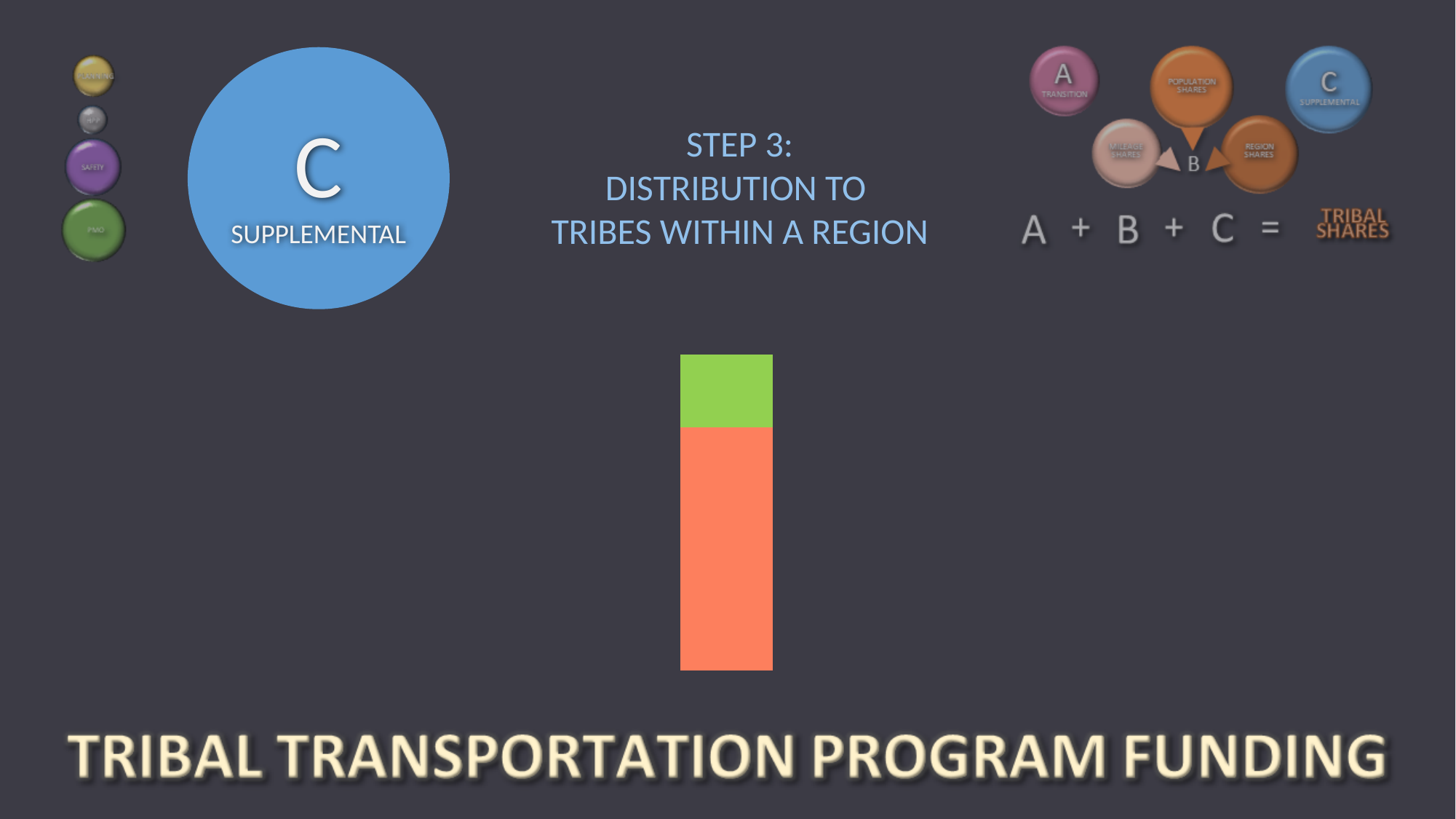
What colour is the top segment of the stacked bar in the centre of the slide? green In the stacked bar in the centre of the slide, which segment is larger, the orange one or the green one? the orange one How many coloured segments make up the stacked bar in the centre of the slide? 2 What colour is the bottom segment of the stacked bar in the centre of the slide? orange How many bars does the chart in the centre of the slide contain? 1 What kind of chart is shown in the centre of the slide? bar chart